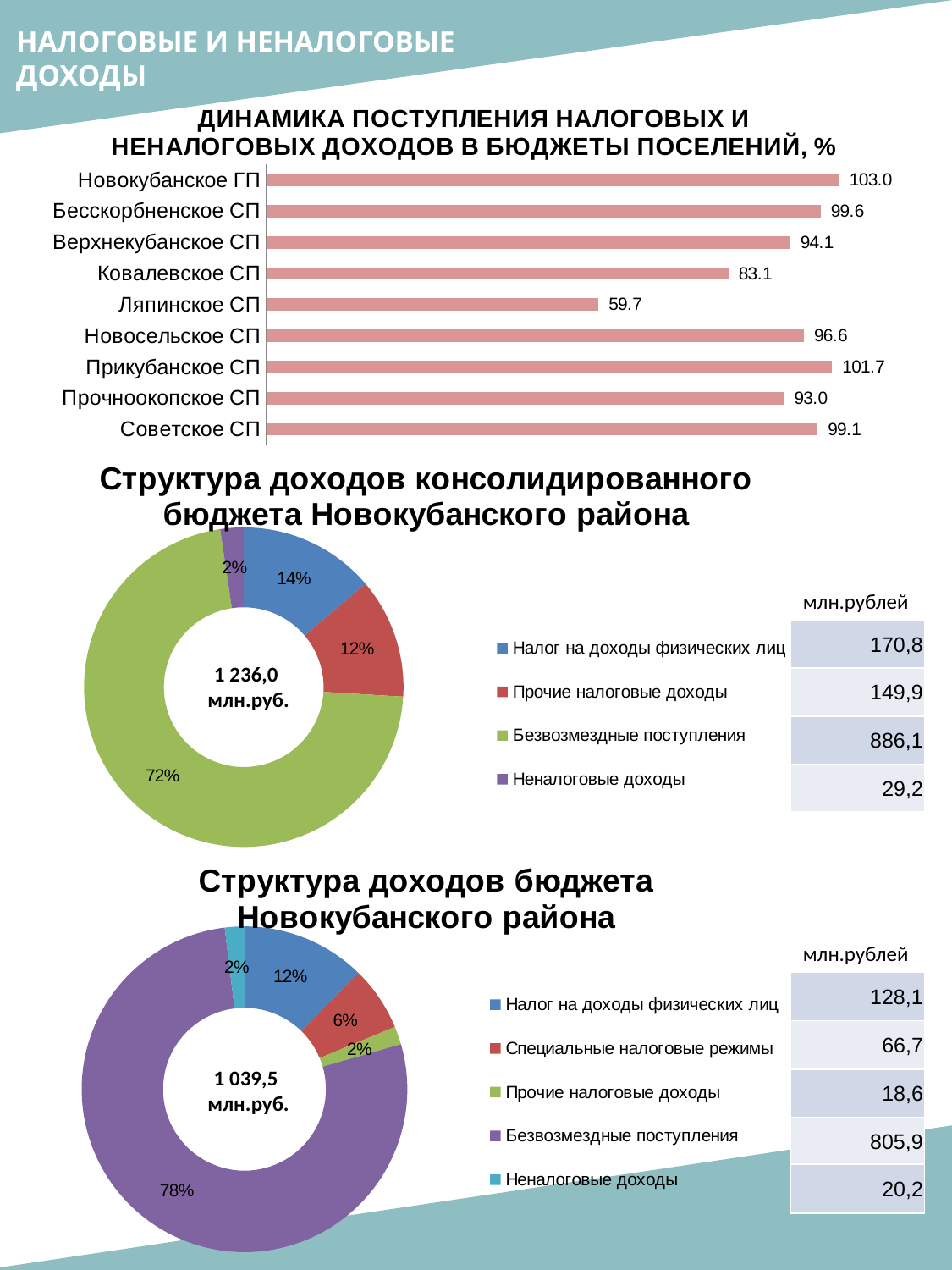
In the bar chart 'Динамика поступления налоговых и неналоговых доходов в бюджеты поселений, %', what is the difference between the values for Новокубанское ГП and Ляпинское СП? 43.3 In the bar chart 'Динамика поступления налоговых и неналоговых доходов в бюджеты поселений, %', which is larger: the value for Прикубанское СП or Бесскорбненское СП? Прикубанское СП In the doughnut chart 'Структура доходов консолидированного бюджета Новокубанского района', what is the value in млн.рублей for Налог на доходы физических лиц? 170,8 In the bar chart 'Динамика поступления налоговых и неналоговых доходов в бюджеты поселений, %', which settlement has the lowest value? Ляпинское СП In the doughnut chart 'Структура доходов консолидированного бюджета Новокубанского района', what share is Безвозмездные поступления? 72% What total is shown in the centre of the doughnut chart 'Структура доходов бюджета Новокубанского района'? 1 039,5 млн.руб. How many series does the legend list for the doughnut chart 'Структура доходов бюджета Новокубанского района'? 5 How many settlements are shown in the bar chart 'Динамика поступления налоговых и неналоговых доходов в бюджеты поселений, %'? 9 In the bar chart 'Динамика поступления налоговых и неналоговых доходов в бюджеты поселений, %', which settlement has the highest value? Новокубанское ГП In the bar chart 'Динамика поступления налоговых и неналоговых доходов в бюджеты поселений, %', what is the value for Ковалевское СП? 83.1 What type of chart is the top chart 'Динамика поступления налоговых и неналоговых доходов в бюджеты поселений, %'? Bar chart In the doughnut chart 'Структура доходов бюджета Новокубанского района', what share is Специальные налоговые режимы? 6%